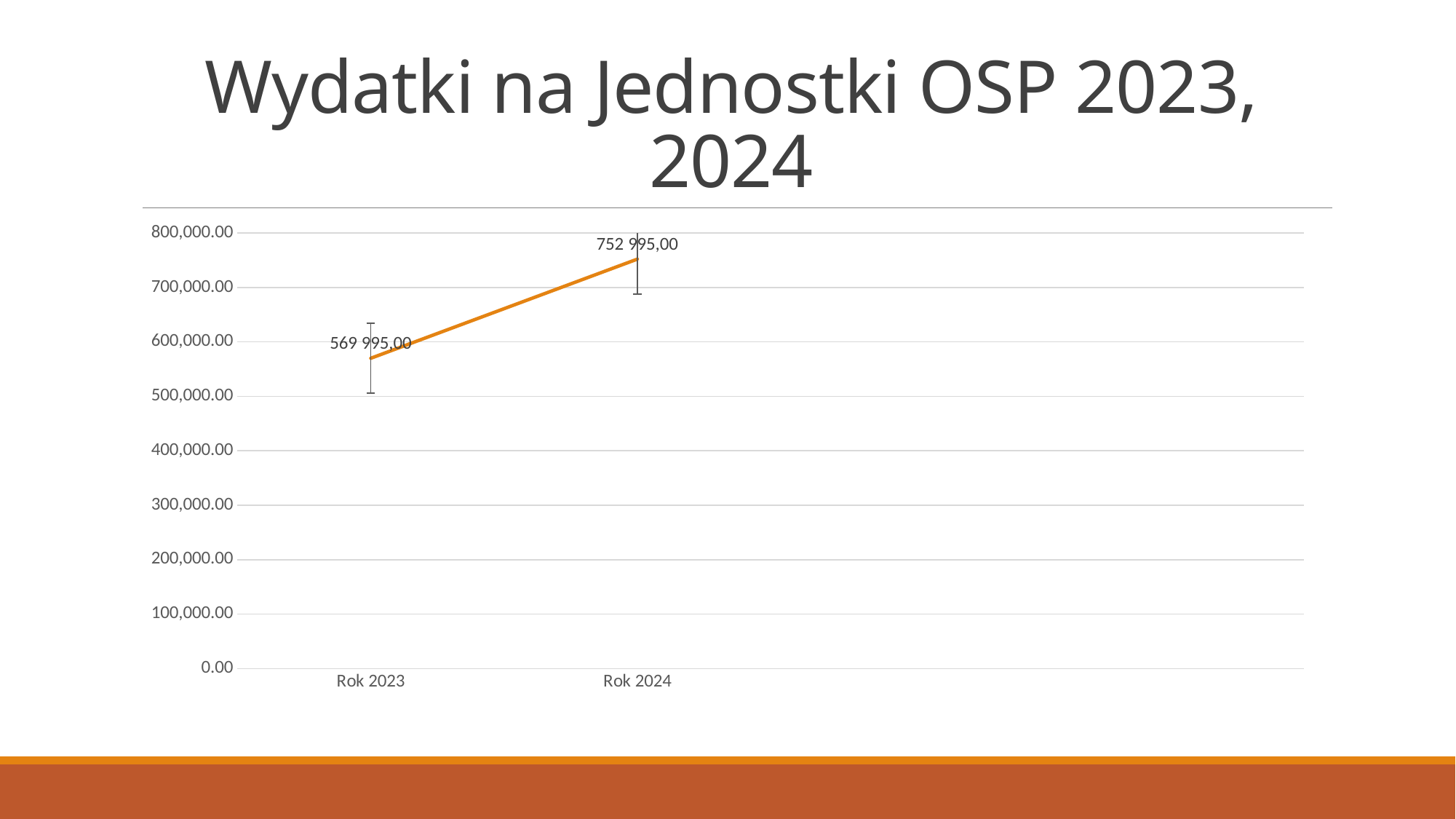
Is the value for Rok 2023 greater or less than 600,000.00? less Which year has the lower value? Rok 2023 What is the value for Rok 2024? 752 995,00 What is the difference between the values for Rok 2024 and Rok 2023? 183 000,00 What kind of chart is shown on the slide? line chart What is the title of the slide? Wydatki na Jednostki OSP 2023, 2024 Is the value for Rok 2024 greater or less than 700,000.00? greater What is the value for Rok 2023? 569 995,00 Which year has the higher value? Rok 2024 How many data points are plotted on the chart? 2 Is the value for Rok 2023 larger or smaller than the value for Rok 2024? smaller Do the values rise or fall from Rok 2023 to Rok 2024? rise